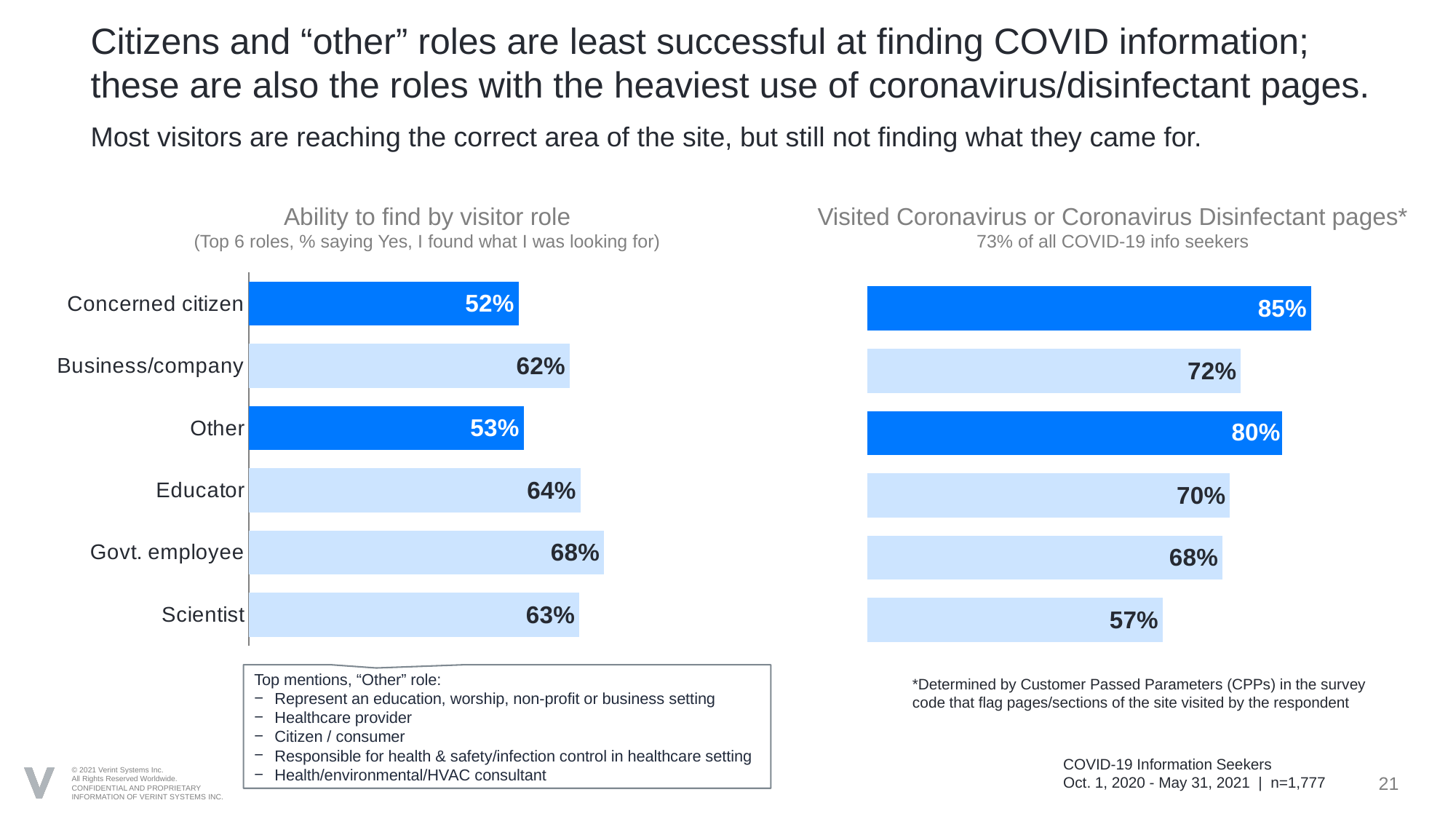
In the 'Ability to find by visitor role' chart, what percentage is shown for Govt. employee? 68% In the 'Ability to find by visitor role' chart, which role has the lowest percentage? Concerned citizen In the 'Ability to find by visitor role' chart, which role has the highest percentage? Govt. employee How many roles are shown in the 'Ability to find by visitor role' chart? 6 In the 'Visited Coronavirus or Coronavirus Disinfectant pages' chart, what percentage is shown on the top bar (Concerned citizen row)? 85% According to the subtitle of the 'Visited Coronavirus or Coronavirus Disinfectant pages' chart, what share of all COVID-19 info seekers visited these pages? 73% In the 'Ability to find by visitor role' chart, what percentage is shown for Concerned citizen? 52% In the 'Ability to find by visitor role' chart, what is the difference between the Educator and Other percentages? 11% In the 'Visited Coronavirus or Coronavirus Disinfectant pages' chart, what percentage is shown on the bottom bar (Scientist row)? 57% In the 'Visited Coronavirus or Coronavirus Disinfectant pages' chart, what is the difference between the top bar (85%) and the bottom bar (57%)? 28% What type of chart is the 'Visited Coronavirus or Coronavirus Disinfectant pages' chart? bar chart In the 'Ability to find by visitor role' chart, which is larger: Business/company or Scientist? Business/company